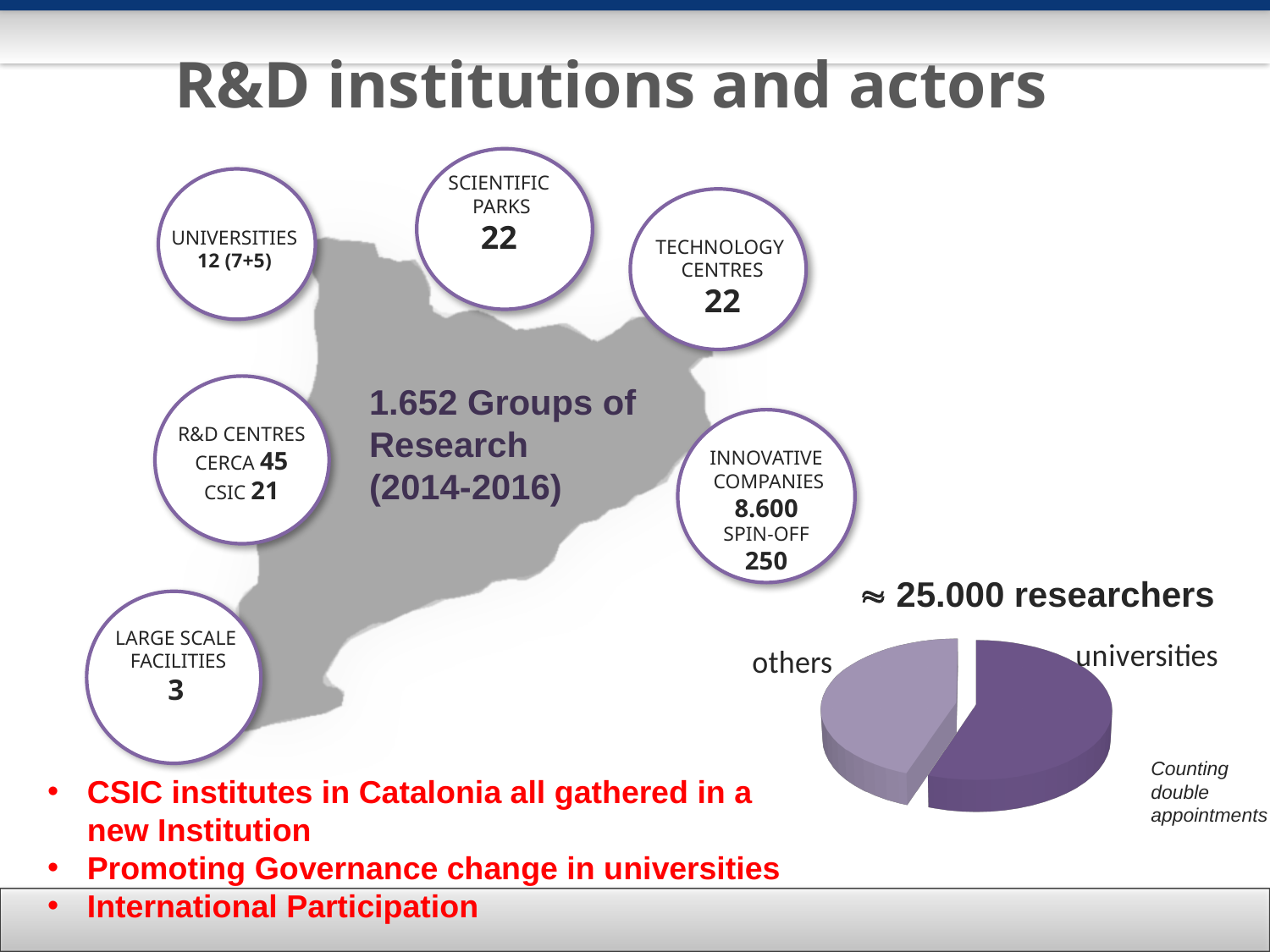
Which category has the smallest share of the pie chart? others What kind of chart is shown on the slide? pie chart Which slice of the pie chart is larger, universities or others? universities How many slices does the pie chart have? 2 What heading appears above the pie chart? ≈ 25.000 researchers What are the two categories labelled on the pie chart? universities and others Which category has the largest share of the pie chart? universities